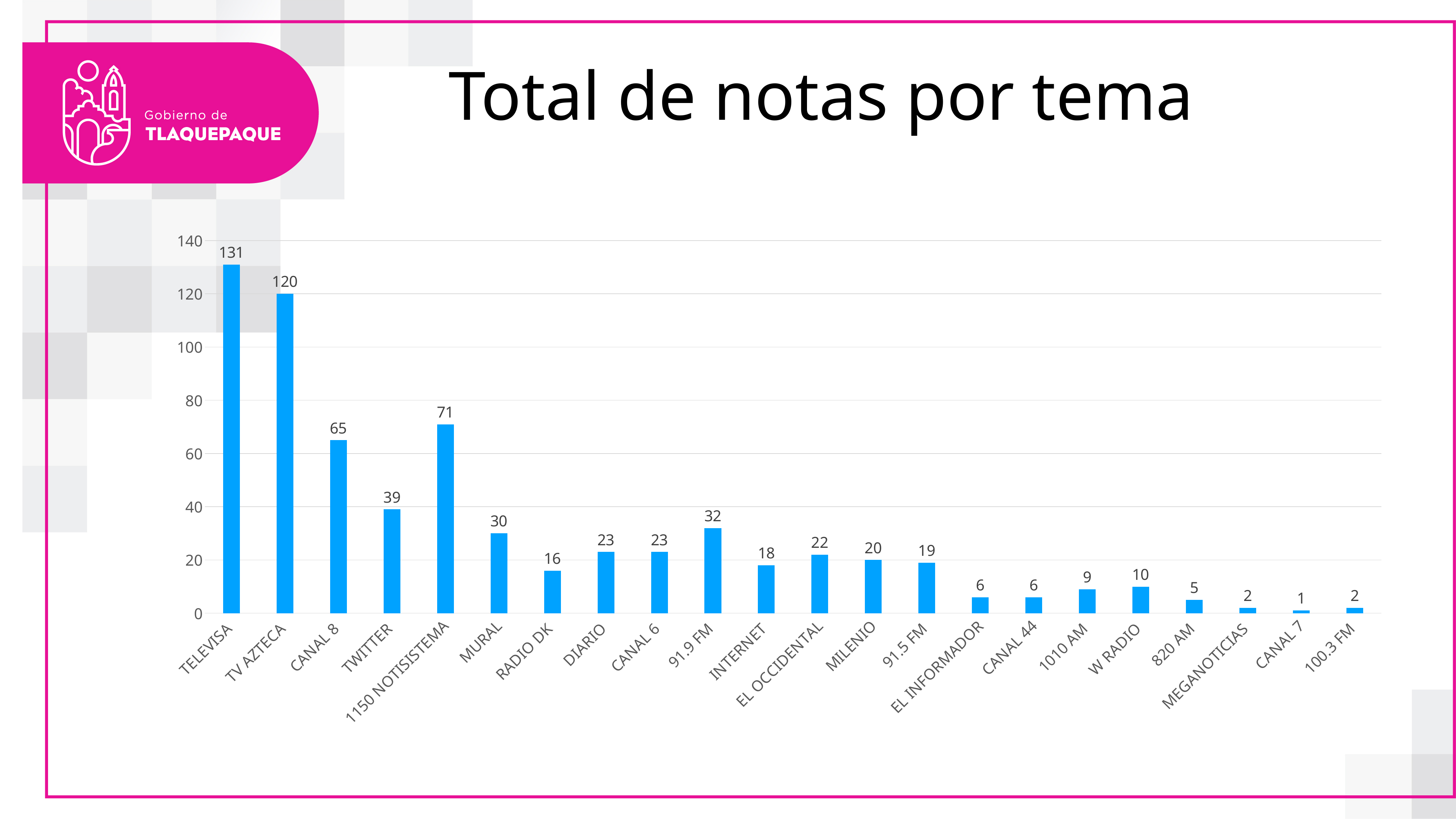
What kind of chart is shown on the slide? Bar chart Which category has the highest value? TELEVISA What is the value for 91.9 FM? 32 How many categories are shown on the x axis? 22 What is the difference between the values for CANAL 8 and TWITTER? 26 What is the title of the chart? Total de notas por tema Which is larger, the value for MURAL or the value for 91.9 FM? 91.9 FM What is the value for TELEVISA? 131 What is the value for 1150 NOTISISTEMA? 71 What is the difference between the values for TELEVISA and TV AZTECA? 11 What is the value for W RADIO? 10 Which category has the lowest value? CANAL 7